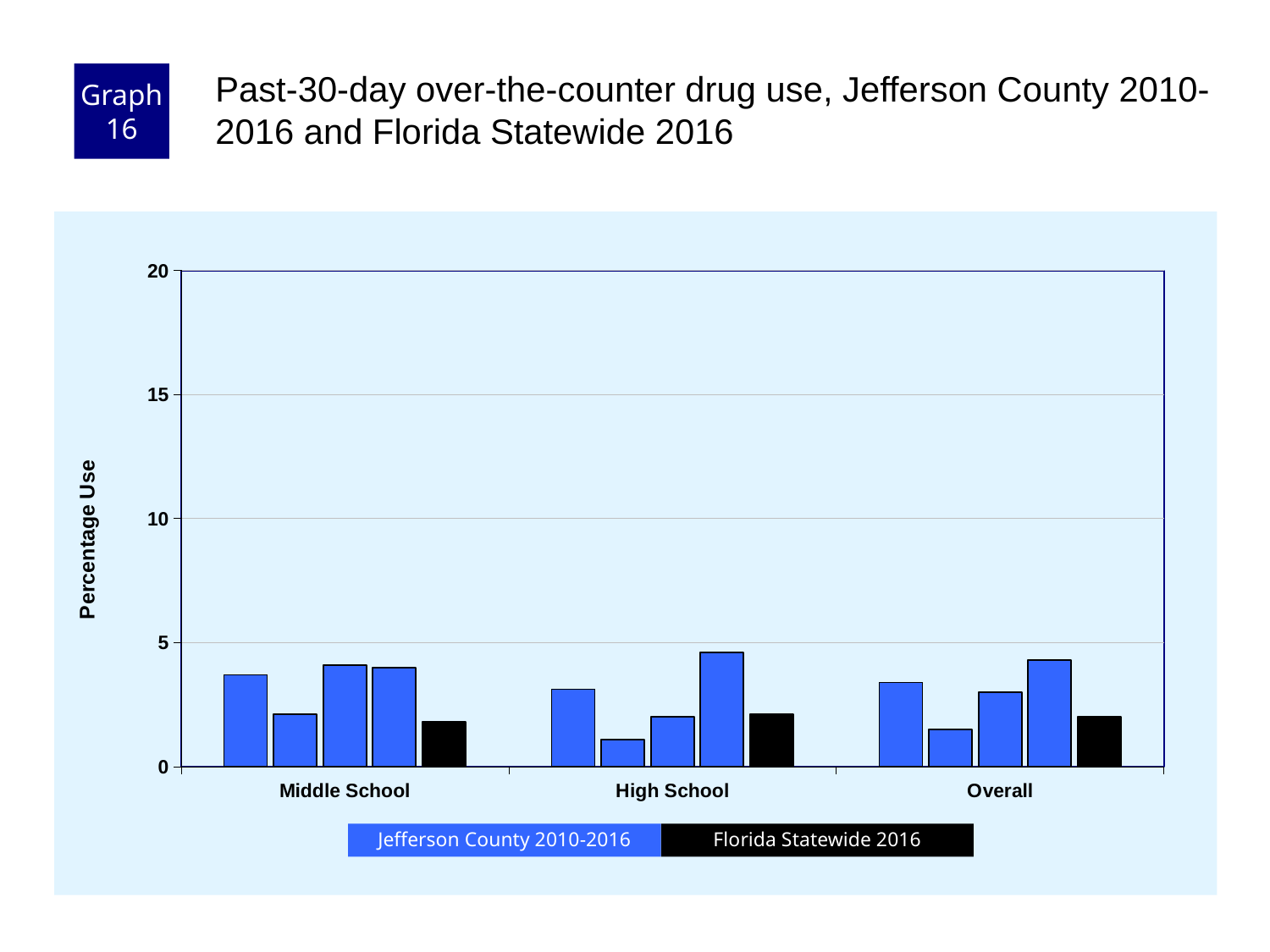
How many series does the legend list? 2 Within the High School group, which bar is the lowest? the second Jefferson County 2010-2016 bar For High School, which is larger: the tallest Jefferson County 2010-2016 bar or the Florida Statewide 2016 bar? the tallest Jefferson County 2010-2016 bar Within the High School group, which bar is the tallest? the fourth Jefferson County 2010-2016 bar Is the tallest Jefferson County 2010-2016 bar for High School greater or less than 5? less What kind of chart is shown on the slide? bar chart What is the highest value shown on the y axis? 20 How many categories are shown on the x axis? 3 What is the label of the y axis? Percentage Use Is the Florida Statewide 2016 value for Overall greater or less than 5? less What are the two series named in the legend? Jefferson County 2010-2016 and Florida Statewide 2016 Is the Florida Statewide 2016 value for Middle School greater or less than 5? less